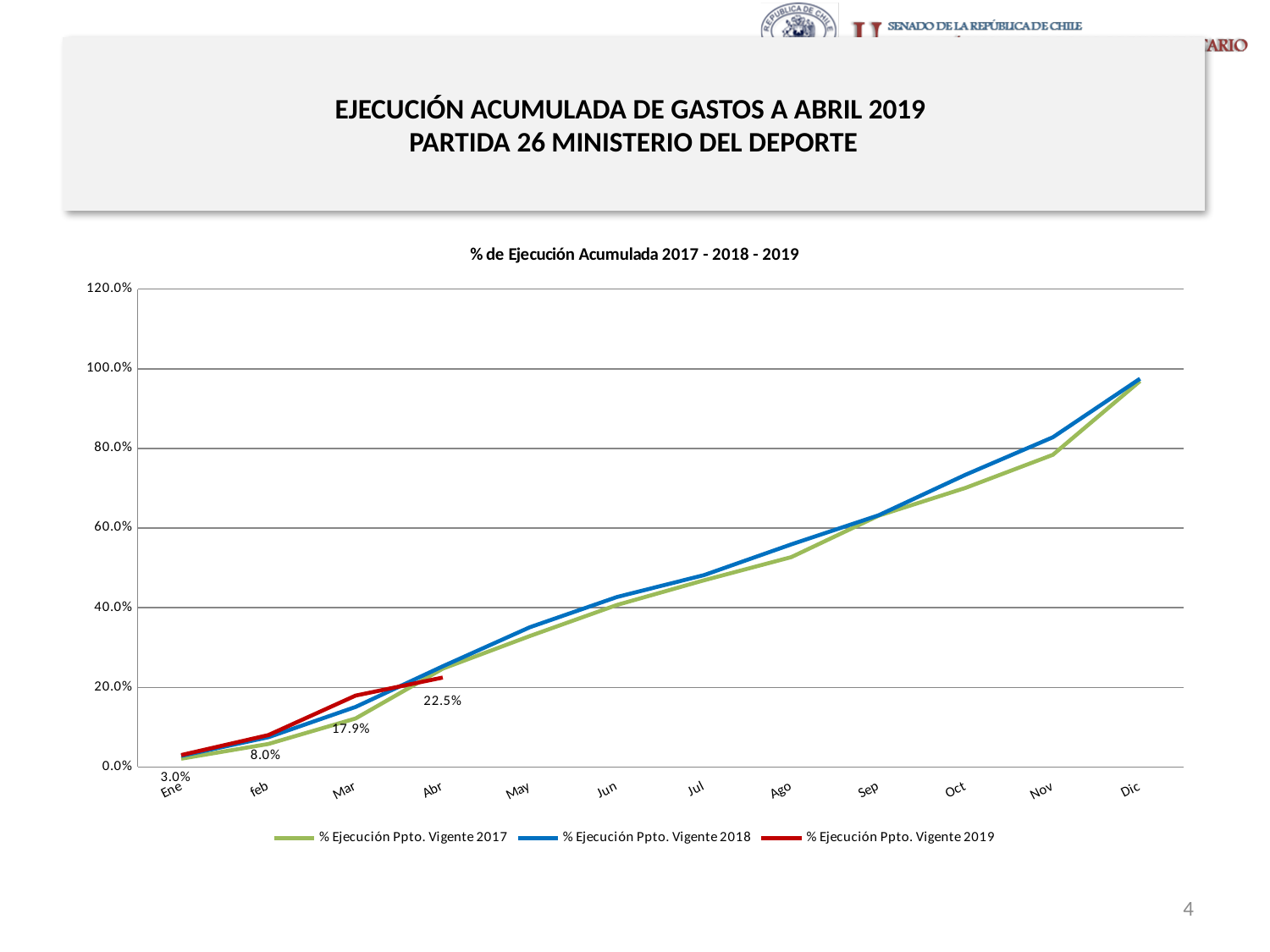
Is the value for % Ejecución Ppto. Vigente 2017 in Ago greater or less than 60.0%? less What is the value of % Ejecución Ppto. Vigente 2019 for Abr? 22.5% What is the value of % Ejecución Ppto. Vigente 2019 for Ene? 3.0% How many months are shown on the x axis? 12 How many series does the legend list? 3 What kind of chart is shown on the slide? Line chart Which month has the highest value for the % Ejecución Ppto. Vigente 2019 series? Abr What is the value of % Ejecución Ppto. Vigente 2019 for Mar? 17.9% What is the title of the chart? % de Ejecución Acumulada 2017 - 2018 - 2019 Do the values for % Ejecución Ppto. Vigente 2018 rise or fall from Ene to Dic? Rise What is the difference between the 2019 values for Abr and Mar? 4.6% What is the value of % Ejecución Ppto. Vigente 2019 for feb? 8.0%